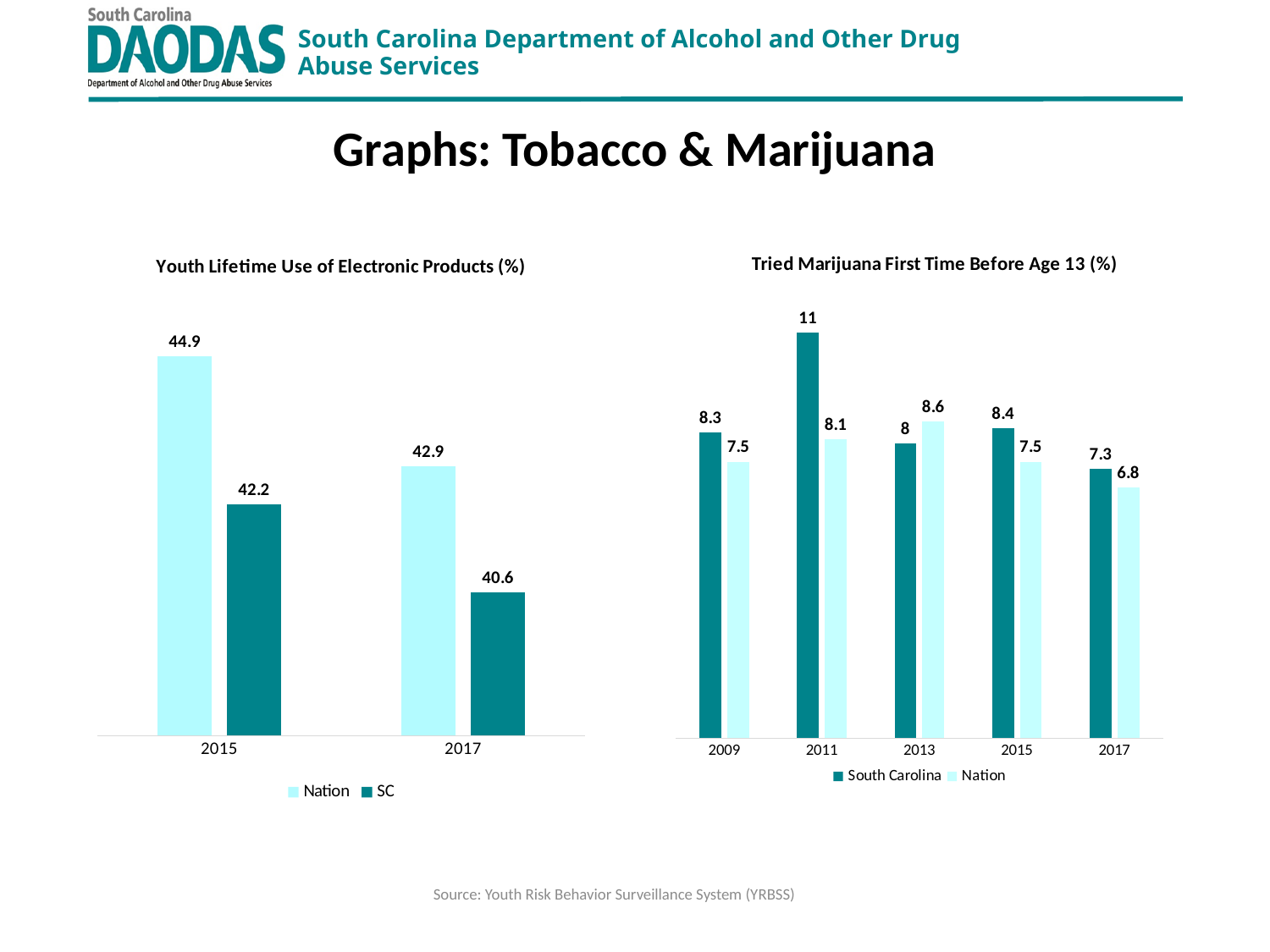
What kind of chart is the 'Tried Marijuana First Time Before Age 13 (%)' chart? bar chart In the 'Youth Lifetime Use of Electronic Products (%)' chart, does the SC value rise or fall from 2015 to 2017? fall In the 'Tried Marijuana First Time Before Age 13 (%)' chart, what is the South Carolina value for 2011? 11 In the 'Tried Marijuana First Time Before Age 13 (%)' chart, which year has the lowest Nation value? 2017 In the 'Tried Marijuana First Time Before Age 13 (%)' chart, what is the Nation value for 2017? 6.8 In the 'Youth Lifetime Use of Electronic Products (%)' chart, what is the SC value for 2017? 40.6 In the 'Tried Marijuana First Time Before Age 13 (%)' chart, which year has the highest South Carolina value? 2011 In the 'Youth Lifetime Use of Electronic Products (%)' chart, how many series does the legend list? 2 In the 'Youth Lifetime Use of Electronic Products (%)' chart, what is the Nation value for 2015? 44.9 In the 'Tried Marijuana First Time Before Age 13 (%)' chart, how many years are shown on the x axis? 5 In the 'Youth Lifetime Use of Electronic Products (%)' chart, what is the difference between the Nation and SC values in 2017? 2.3 In the 'Tried Marijuana First Time Before Age 13 (%)' chart, which is larger in 2013, South Carolina or Nation? Nation